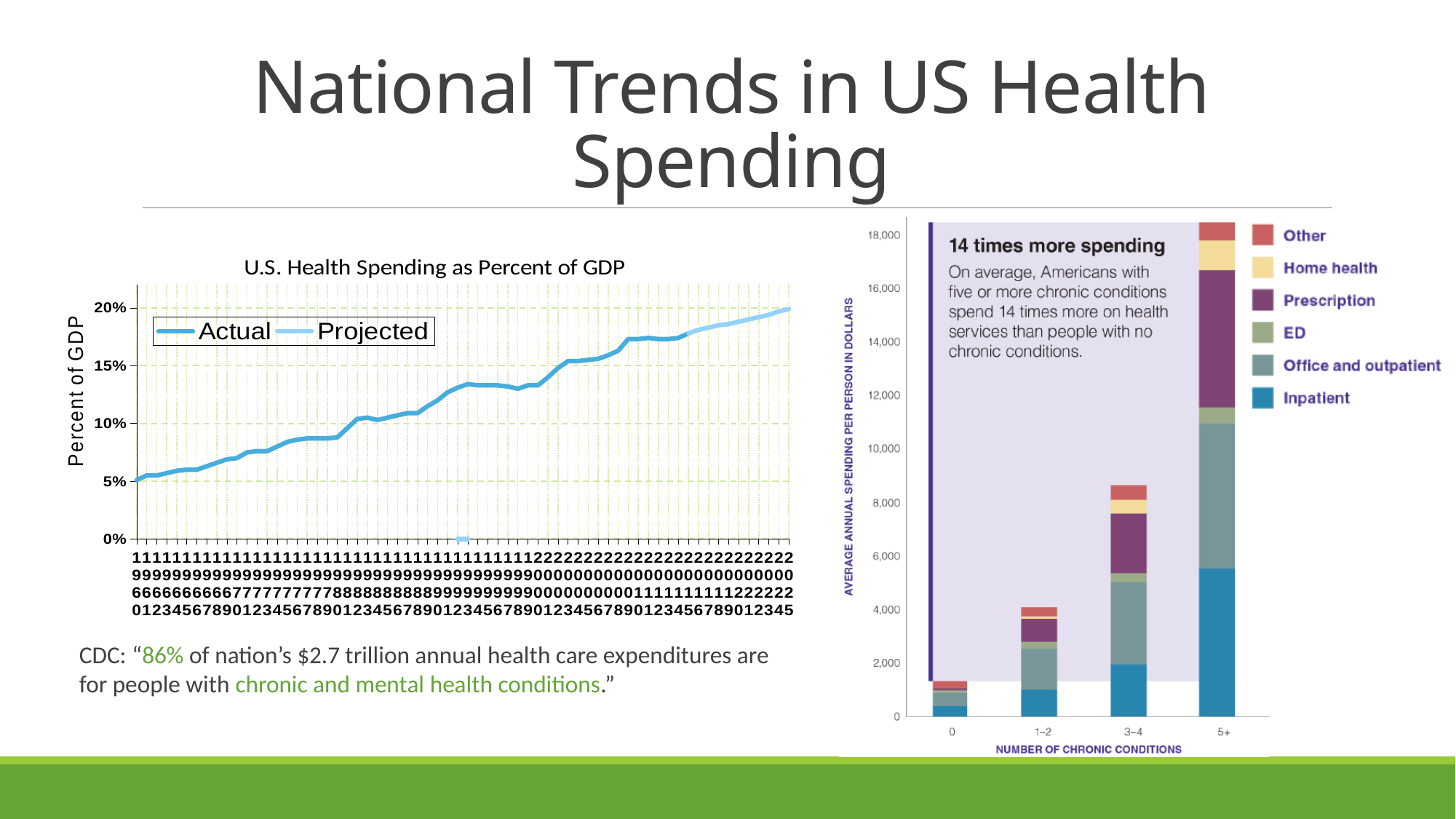
What kind of chart is the 'U.S. Health Spending as Percent of GDP' chart on the left? line chart In the 'U.S. Health Spending as Percent of GDP' chart, is the value for 2000 greater or less than 10%? greater How many series does the legend of the 'U.S. Health Spending as Percent of GDP' chart list? 2 In the chart on the right, which number of chronic conditions has the highest total average annual spending per person? 5+ In the chart on the right, is the total average annual spending for people with 3–4 chronic conditions greater or less than 8,000? greater How many series does the legend of the chart on the right list? 6 What kind of chart is the chart on the right showing average annual spending per person by number of chronic conditions? stacked bar chart How many categories of number of chronic conditions are shown on the x axis of the chart on the right? 4 In the 'U.S. Health Spending as Percent of GDP' chart, is the value for 1980 greater or less than 10%? less In the chart on the right, is the Inpatient spending for people with 5+ chronic conditions larger than the Inpatient spending for people with 3–4 chronic conditions? Yes In the 'U.S. Health Spending as Percent of GDP' chart, do the values rise or fall from 1960 to 2025? rise What is the y-axis label of the 'U.S. Health Spending as Percent of GDP' chart? Percent of GDP